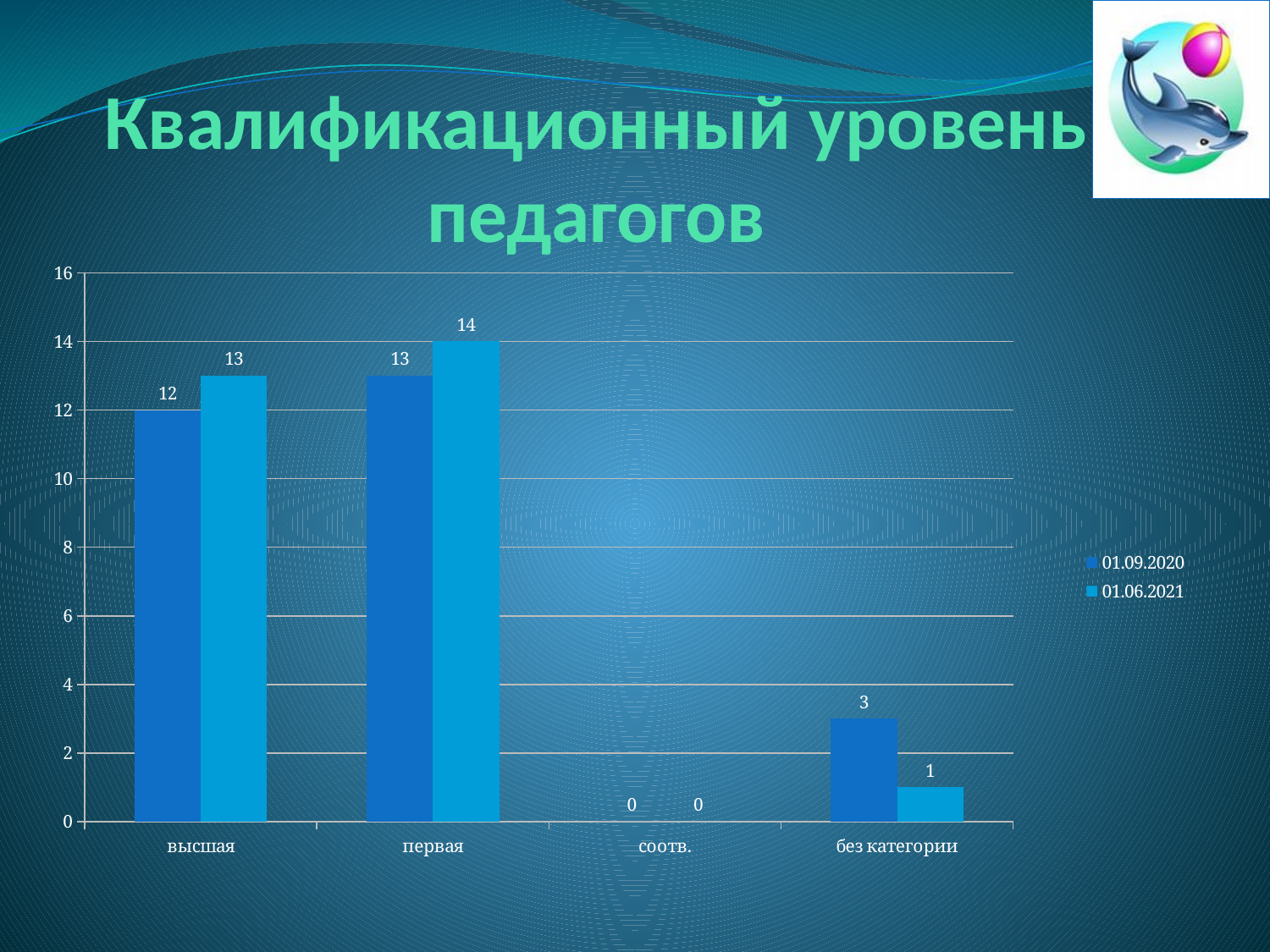
What is the difference between the 01.09.2020 and 01.06.2021 values for без категории? 2 Which category has the lowest value in the 01.09.2020 series? соотв. How many series does the legend list? 2 Which is larger for высшая: the 01.09.2020 value or the 01.06.2021 value? 01.06.2021 What is the value for первая in the 01.06.2021 series? 14 Which category has the highest value in the 01.06.2021 series? первая What is the value for без категории in the 01.09.2020 series? 3 What kind of chart is shown on the slide? bar chart What is the title of the slide? Квалификационный уровень педагогов What is the value for соотв. in the 01.06.2021 series? 0 How many categories are shown on the x axis? 4 What is the value for высшая in the 01.09.2020 series? 12